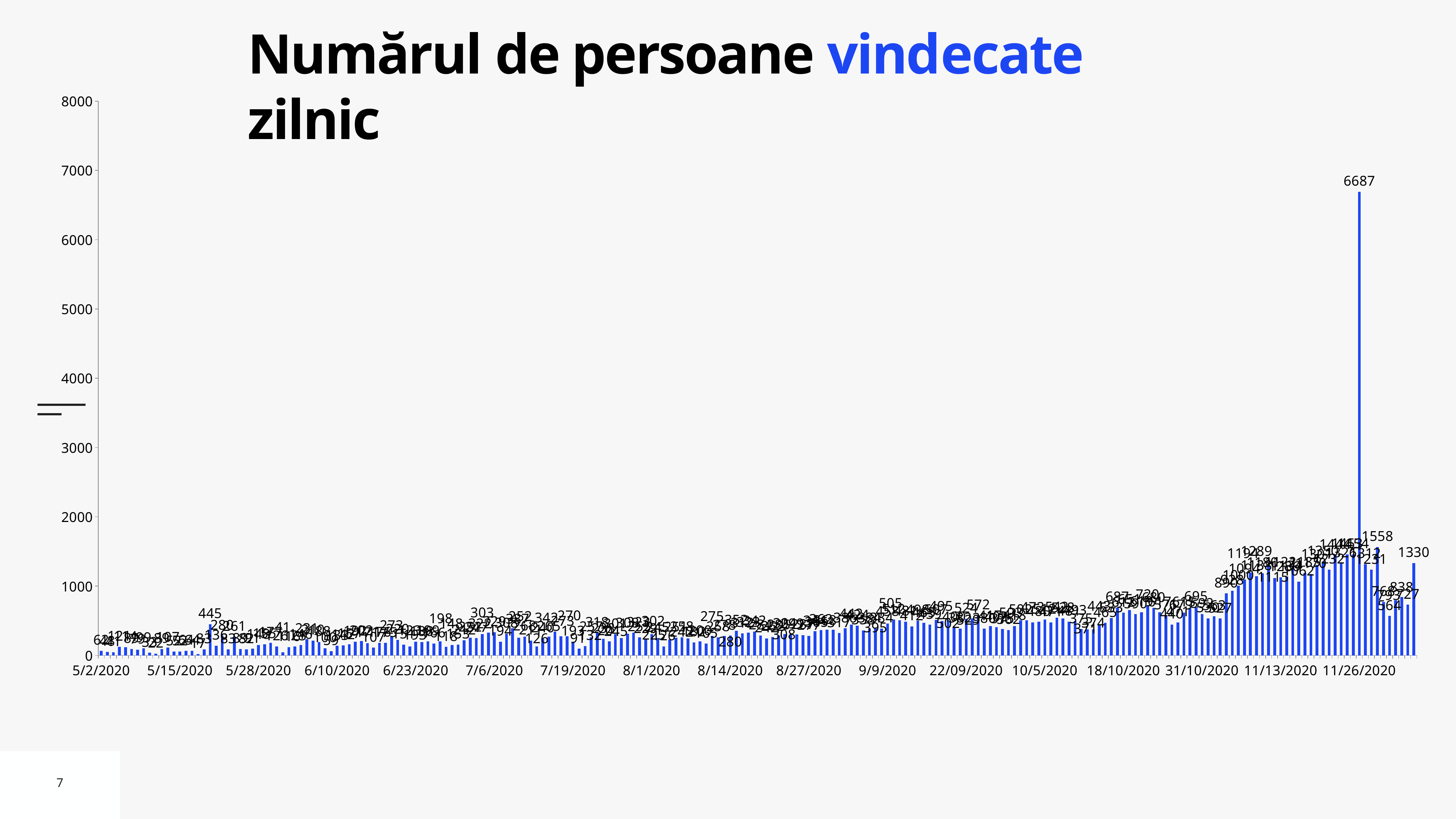
What kind of chart is shown on the slide? bar chart Near which x-axis date label does the tallest bar appear? 11/26/2020 Is the bar labelled 445 greater or less than 1000? less What is the value labelled on the rightmost (last) bar of the chart? 1330 Are the bars near the 5/2/2020 tick greater or less than 1000? less Overall, do the daily values rise or fall from May 2020 to November 2020 along the x axis? rise What is the highest value labelled on the chart? 6687 What is the title of the chart? Numărul de persoane vindecate zilnic Which is larger, the bar labelled 1558 or the bar labelled 1330? 1558 What is the difference between the bars labelled 1558 and 1330? 228 What is the difference between the highest labelled value (6687) and the last bar's value (1330)? 5357 Is the tallest bar on the chart greater or less than 6000? greater